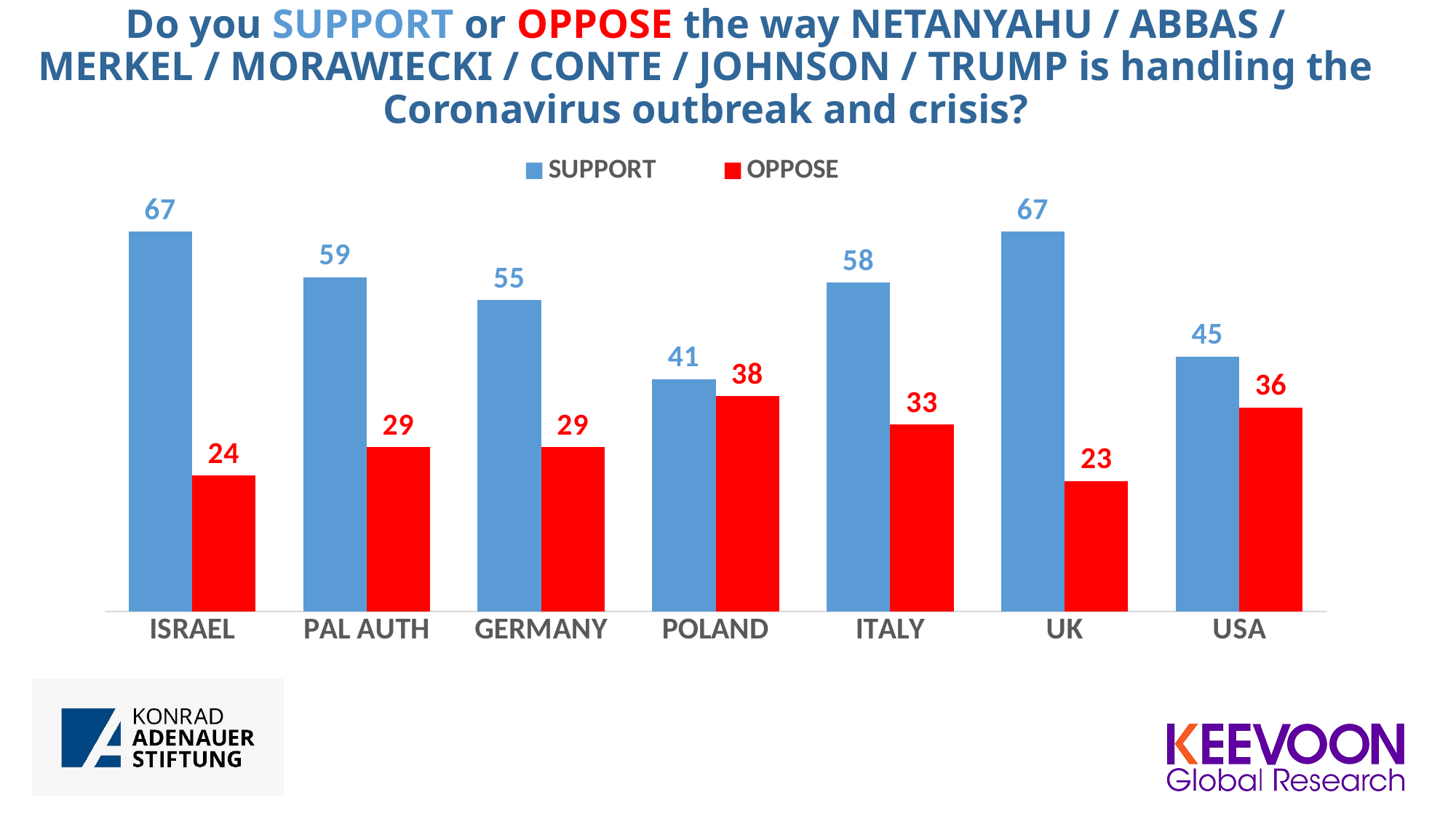
What is the SUPPORT value for Germany? 55 What kind of chart is shown on the slide? Bar chart Which country has the lowest OPPOSE value? UK Which is larger for Italy, the SUPPORT value or the OPPOSE value? SUPPORT What is the SUPPORT value for the USA? 45 What is the OPPOSE value for Poland? 38 What is the difference between the SUPPORT and OPPOSE values for Israel? 43 Which country has the highest OPPOSE value? POLAND What colour are the OPPOSE bars? Red How many series does the legend list? 2 How many countries are shown on the x axis? 7 Which country has the lowest SUPPORT value? POLAND